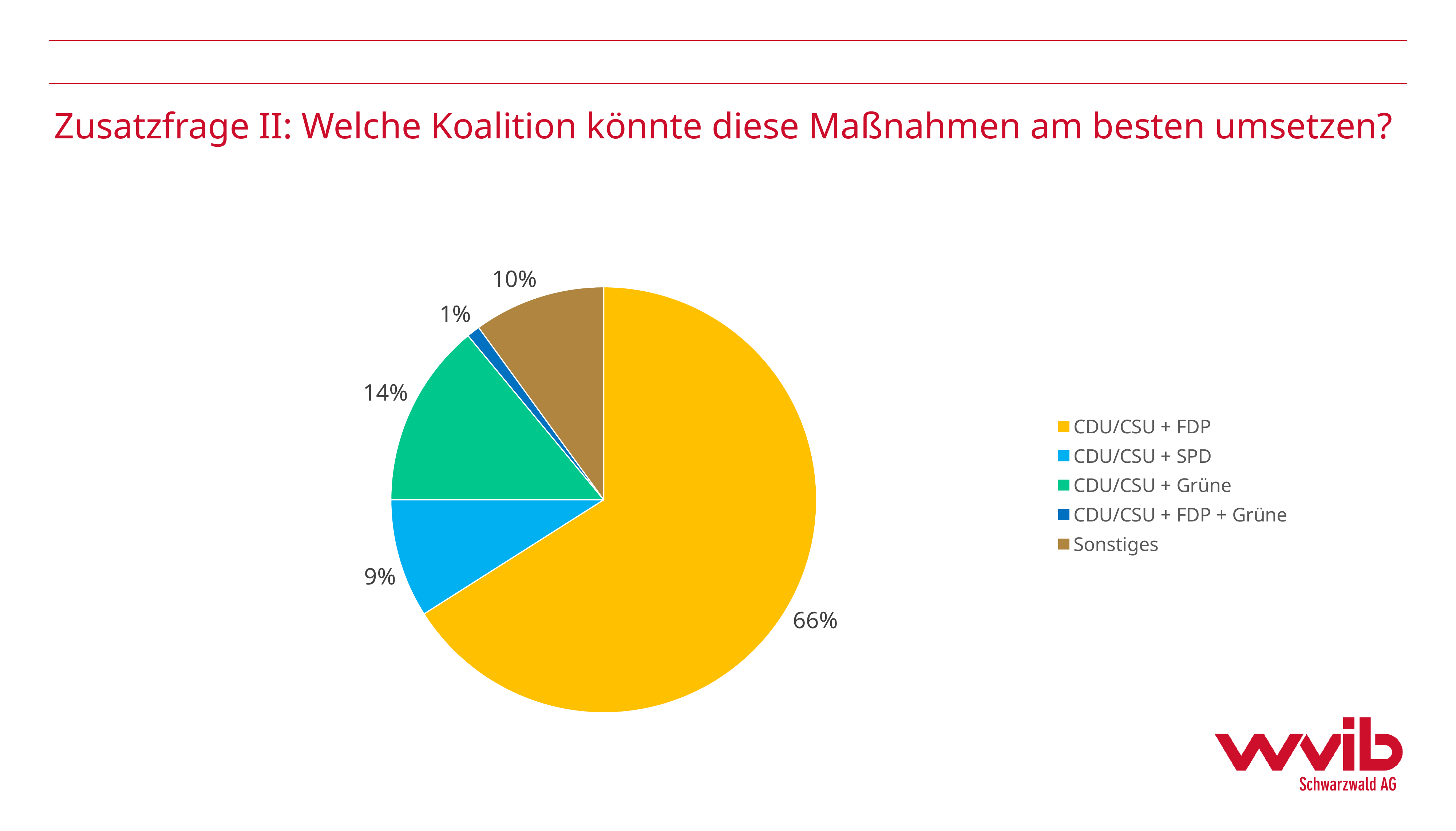
What colour is the slice for Sonstiges? Brown What share of the pie does Sonstiges have? 10% What share of the pie does CDU/CSU + Grüne have? 14% Which coalition has the largest slice of the pie? CDU/CSU + FDP What share of the pie does CDU/CSU + FDP + Grüne have? 1% Which is larger, the slice for CDU/CSU + Grüne or the slice for Sonstiges? CDU/CSU + Grüne Which coalition has the smallest slice of the pie? CDU/CSU + FDP + Grüne How many slices does the pie chart have? 5 What kind of chart is shown on the slide? Pie chart What share of the pie does CDU/CSU + SPD have? 9% What share of the pie does CDU/CSU + FDP have? 66% What is the difference in percentage points between CDU/CSU + FDP and CDU/CSU + Grüne? 52